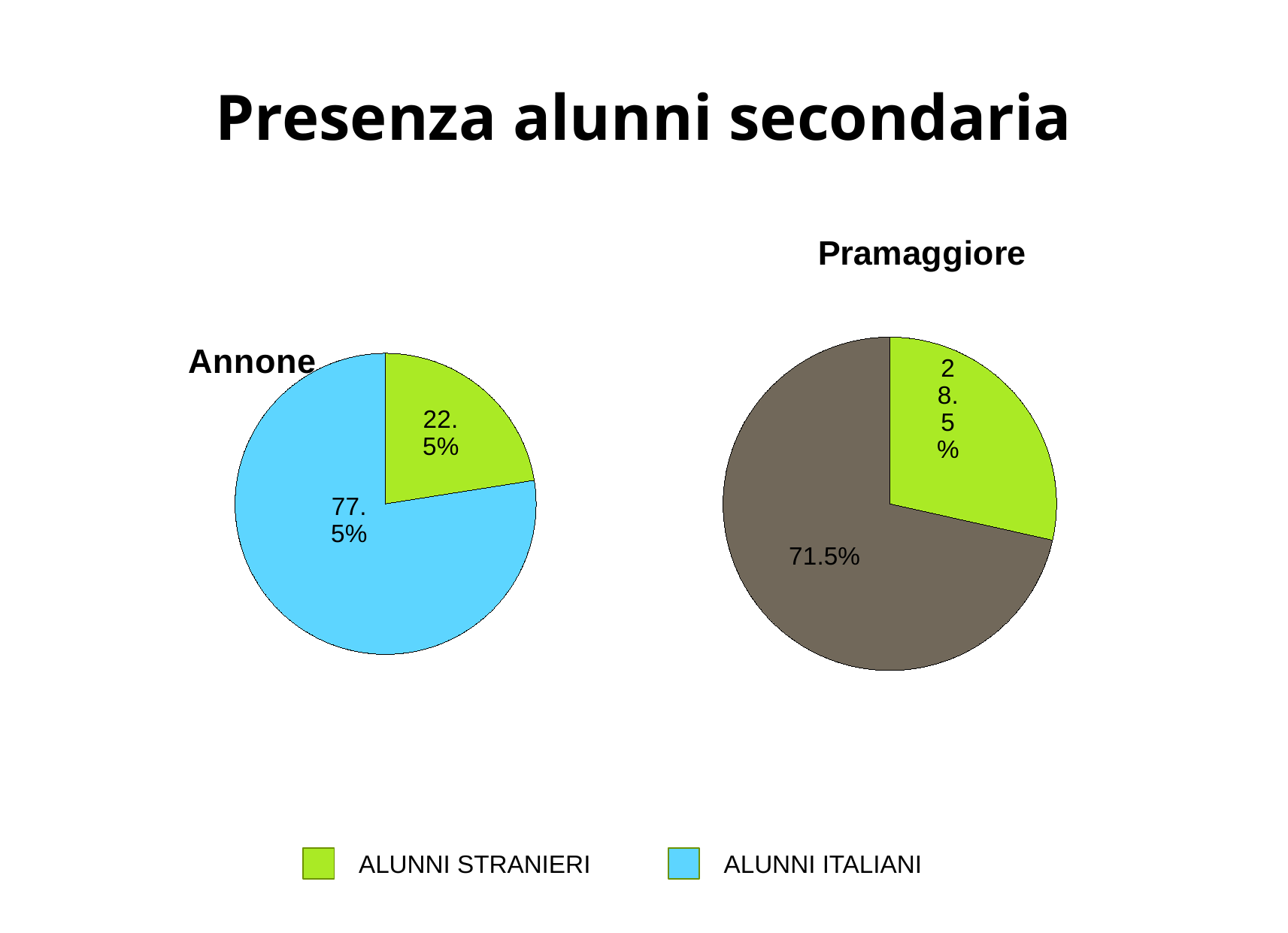
In the Annone chart, which slice is the smallest? ALUNNI STRANIERI In the Annone chart, what share of the pie is ALUNNI ITALIANI? 77.5% In the Annone chart, what is the difference between the ALUNNI ITALIANI share and the ALUNNI STRANIERI share? 55% In the Pramaggiore chart, what percentage is shown on the larger slice? 71.5% How many slices does the Pramaggiore chart have? 2 What kind of chart is used for Annone and Pramaggiore? Pie chart In the Annone chart, which slice is the largest? ALUNNI ITALIANI In the Pramaggiore chart, what share of the pie is the green ALUNNI STRANIERI slice? 28.5% In the Annone chart, what share of the pie is ALUNNI STRANIERI? 22.5% What colour does the legend use for ALUNNI STRANIERI? Green Which chart shows a larger share for ALUNNI STRANIERI, Annone or Pramaggiore? Pramaggiore How many entries does the legend list? 2